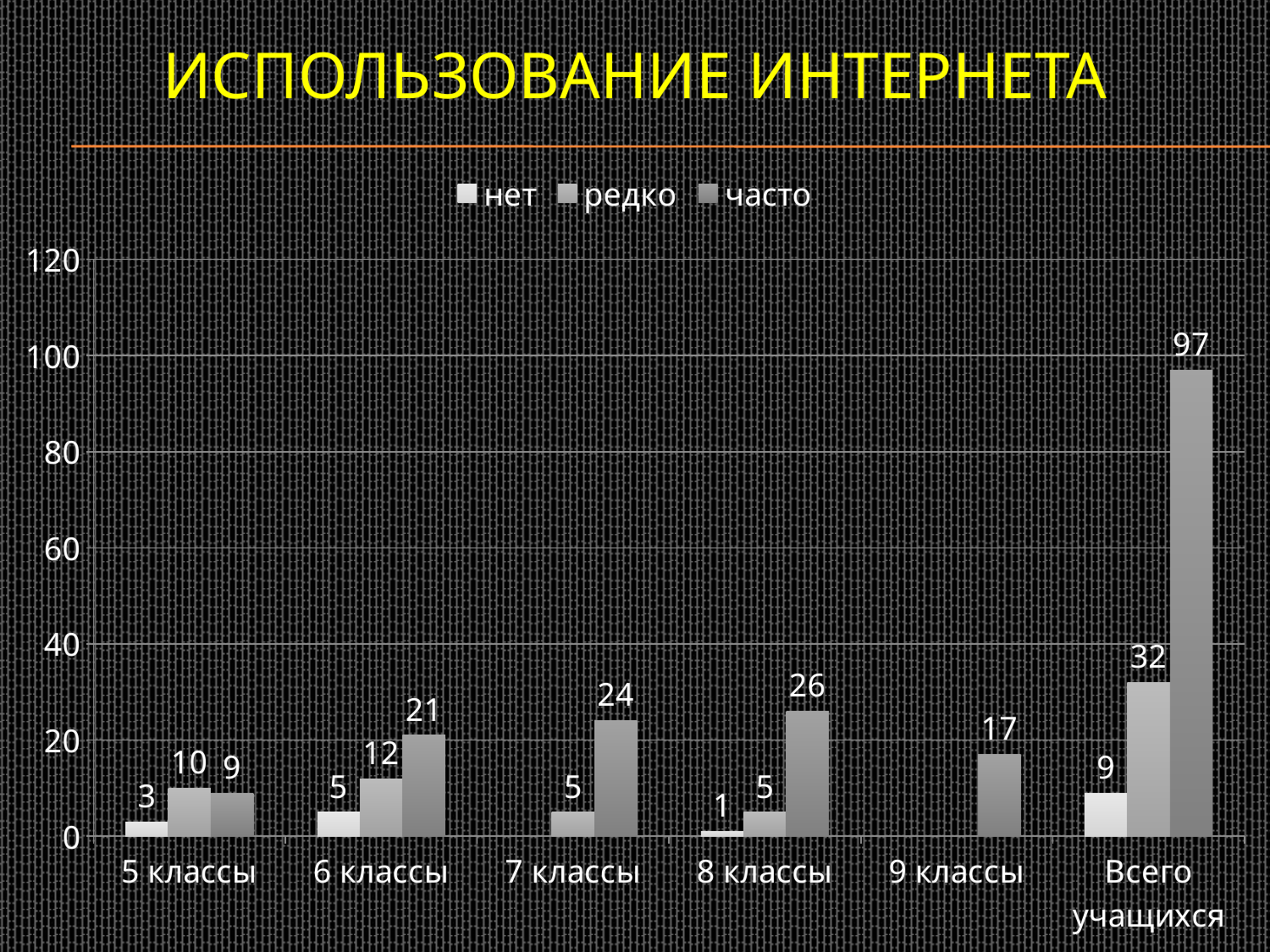
How many series does the legend list? 3 Which is larger for '5 классы': 'редко' or 'часто'? редко What is the value of 'редко' for '6 классы'? 12 What is the value of 'часто' for 'Всего учащихся'? 97 Which category has the lowest 'нет' value among those with a labelled 'нет' bar? 8 классы Is the 'часто' value for 'Всего учащихся' greater or less than 80? greater What is the difference between the 'часто' and 'редко' values for 'Всего учащихся'? 65 What kind of chart is shown on the slide? bar chart What is the value of 'нет' for '8 классы'? 1 What is the value of 'часто' for '9 классы'? 17 What are the three series named in the legend? нет, редко, часто Among the class categories (excluding 'Всего учащихся'), which has the highest 'часто' value? 8 классы